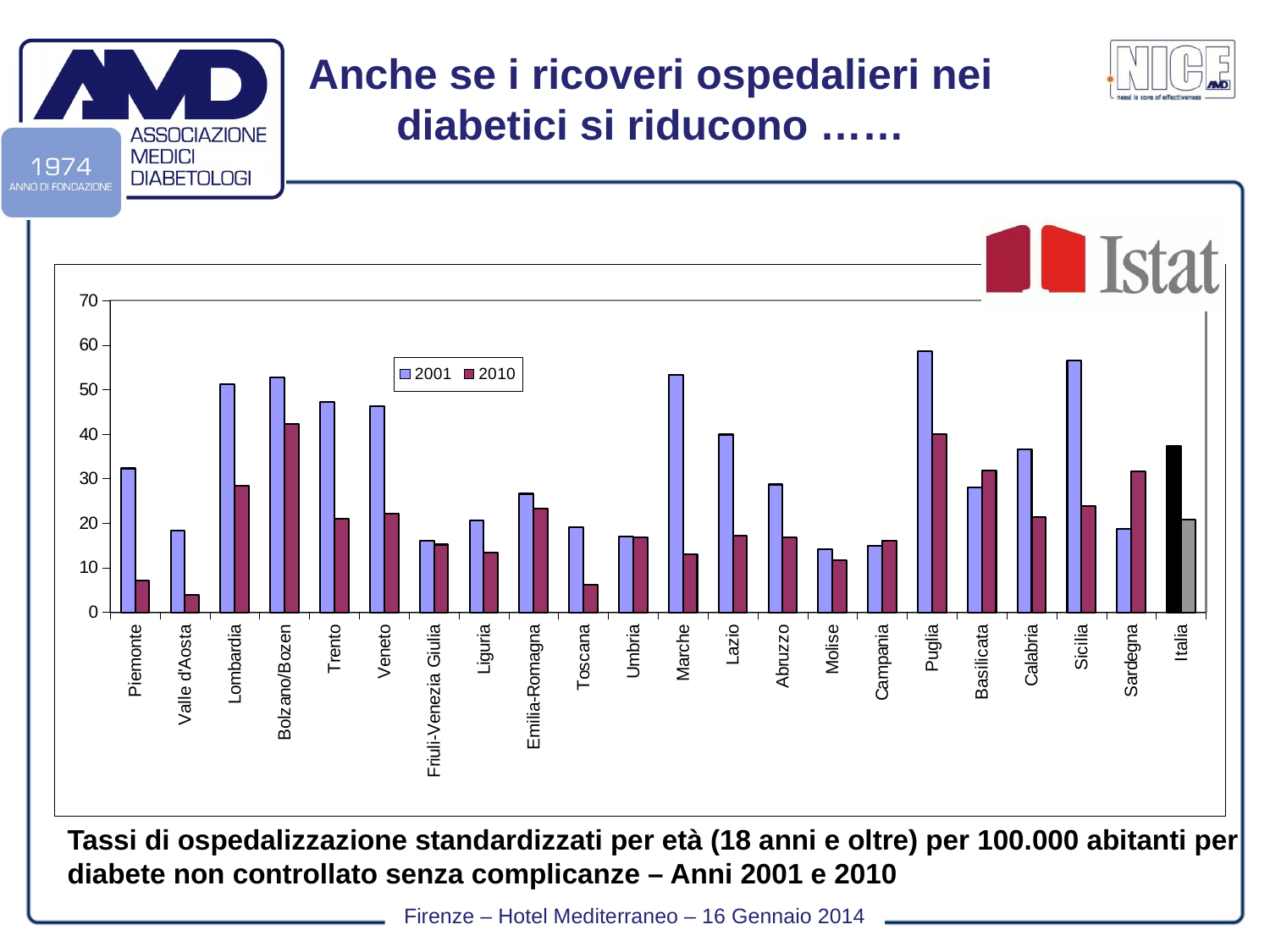
Is the 2010 value for Toscana greater or less than 10? less Is the 2001 value for Valle d'Aosta greater or less than 20? less How many categories are shown on the x axis? 22 Which category has the highest value for 2001? Puglia Is the 2001 value for Italia greater or less than 30? greater What kind of chart is shown on the slide? bar chart For Piemonte, which is larger: the 2001 value or the 2010 value? 2001 Which series are listed in the legend? 2001 and 2010 How many series does the legend list? 2 Which category has the lowest value for 2010? Valle d'Aosta For Sardegna, which is larger: the 2001 value or the 2010 value? 2010